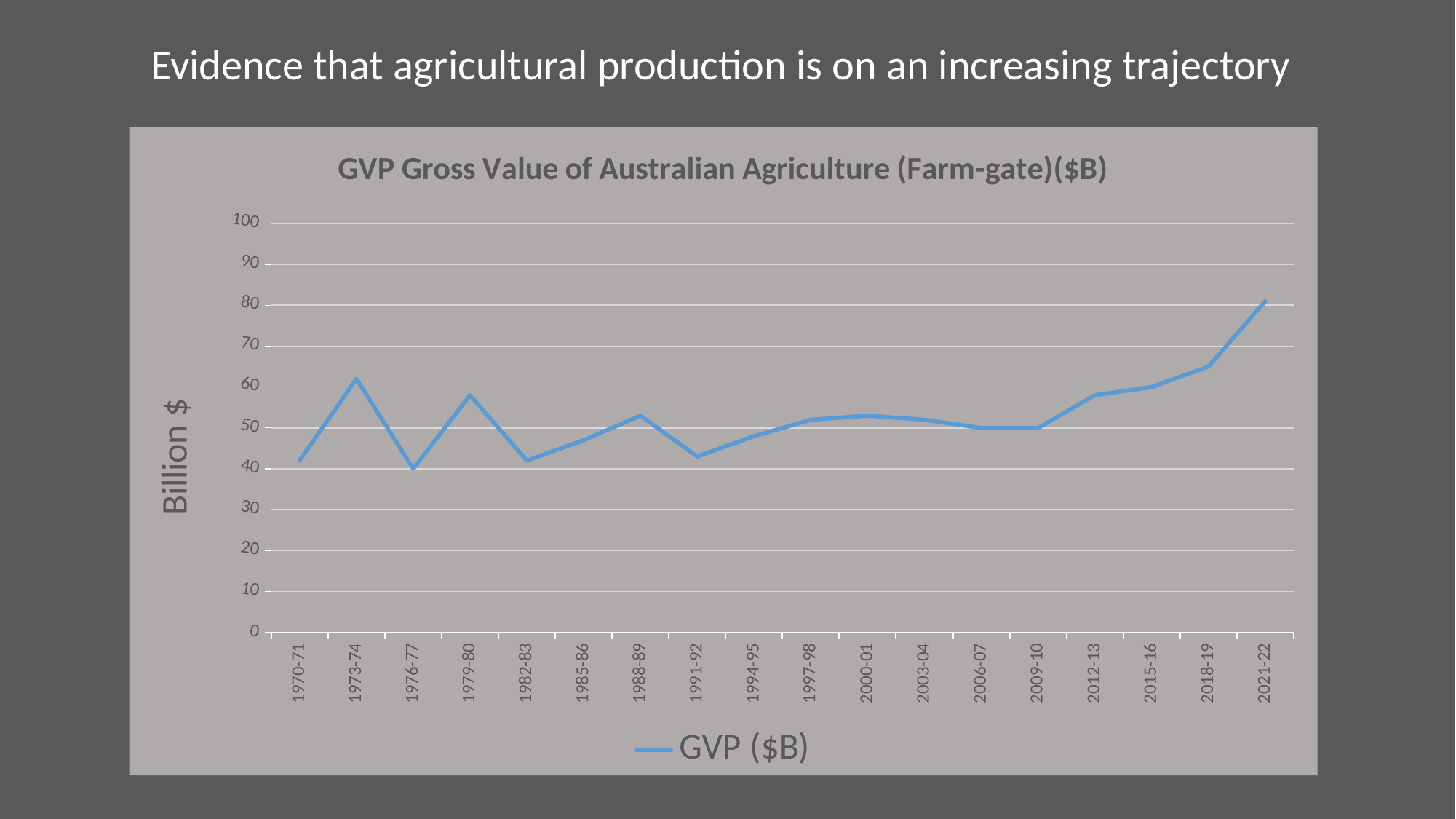
Is the GVP value for 1970-71 greater or less than 50? less How many time periods are plotted along the x axis? 18 Which period has the highest GVP value? 2021-22 What kind of chart is shown on the slide? line chart Which period has the lowest GVP value? 1976-77 Is the GVP value for 2018-19 greater or less than 60? greater How many series does the legend list? 1 Is the GVP value for 2021-22 greater or less than 70? greater Do GVP values rise or fall from 2009-10 to 2021-22? rise Which period has the larger GVP value, 1979-80 or 1982-83? 1979-80 What is the title of the chart? GVP Gross Value of Australian Agriculture (Farm-gate)($B)